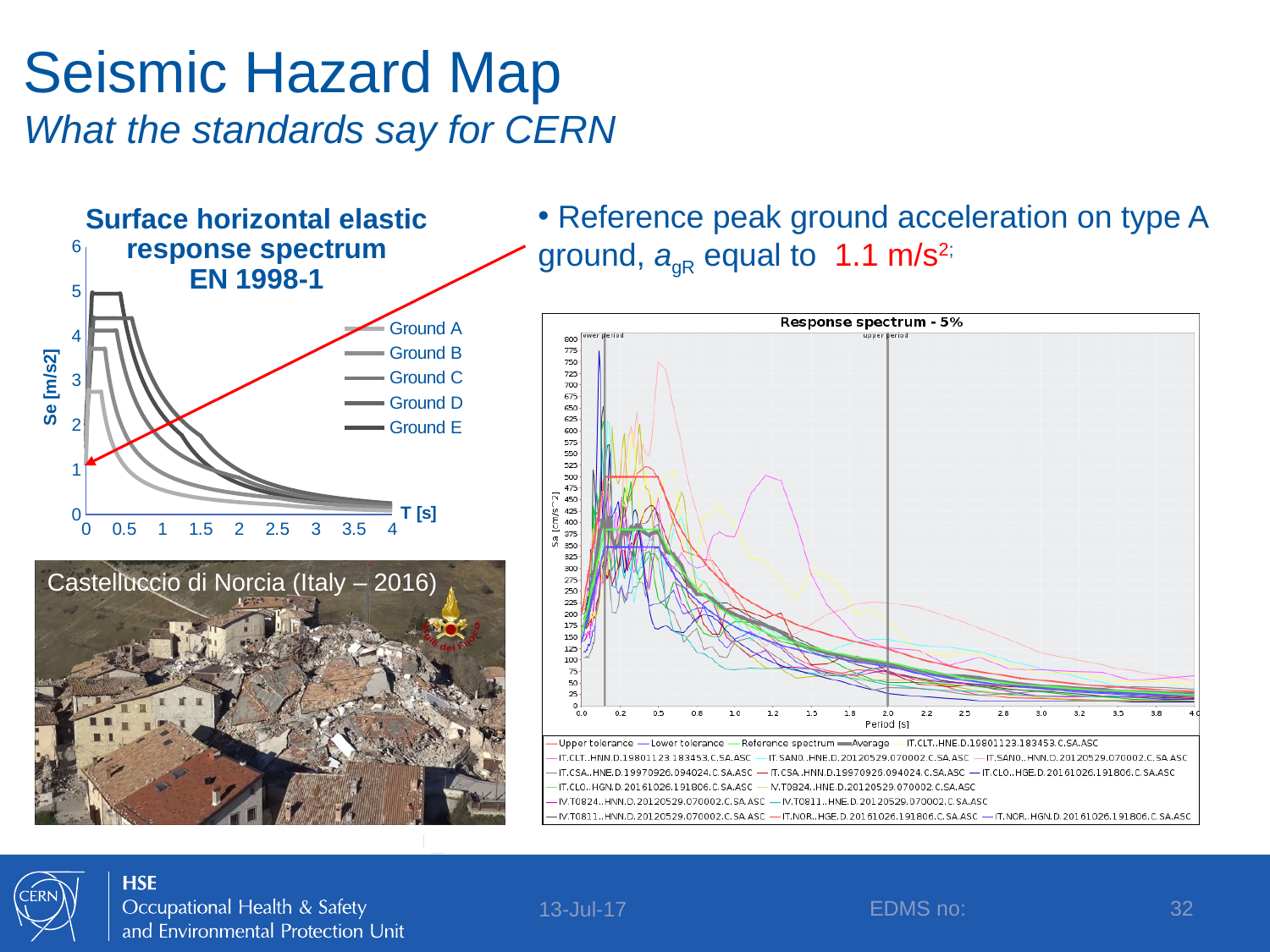
On the right chart, what is the highest tick value shown on the y axis? 800 What kind of chart is the left chart titled 'Surface horizontal elastic response spectrum EN 1998-1'? line chart On the left chart, which ground type has the lowest peak value of Se? Ground A On the left chart, is the peak value for Ground A greater or less than 2 m/s2? greater What is the label of the y axis on the left chart? Se [m/s2] On the left chart, how many series does the legend list? 5 On the left chart, which has the higher peak value, Ground B or Ground D? Ground D On the left chart, is the peak value for Ground E greater or less than 4 m/s2? greater What is the title of the chart on the right side of the slide? Response spectrum - 5% On the left chart, do the values for Ground A rise or fall as T increases from 1 s to 4 s? fall On the left chart, is the value for Ground E at T = 3 s greater or less than 1 m/s2? less On the left chart, which ground type reaches the highest peak value of Se? Ground E